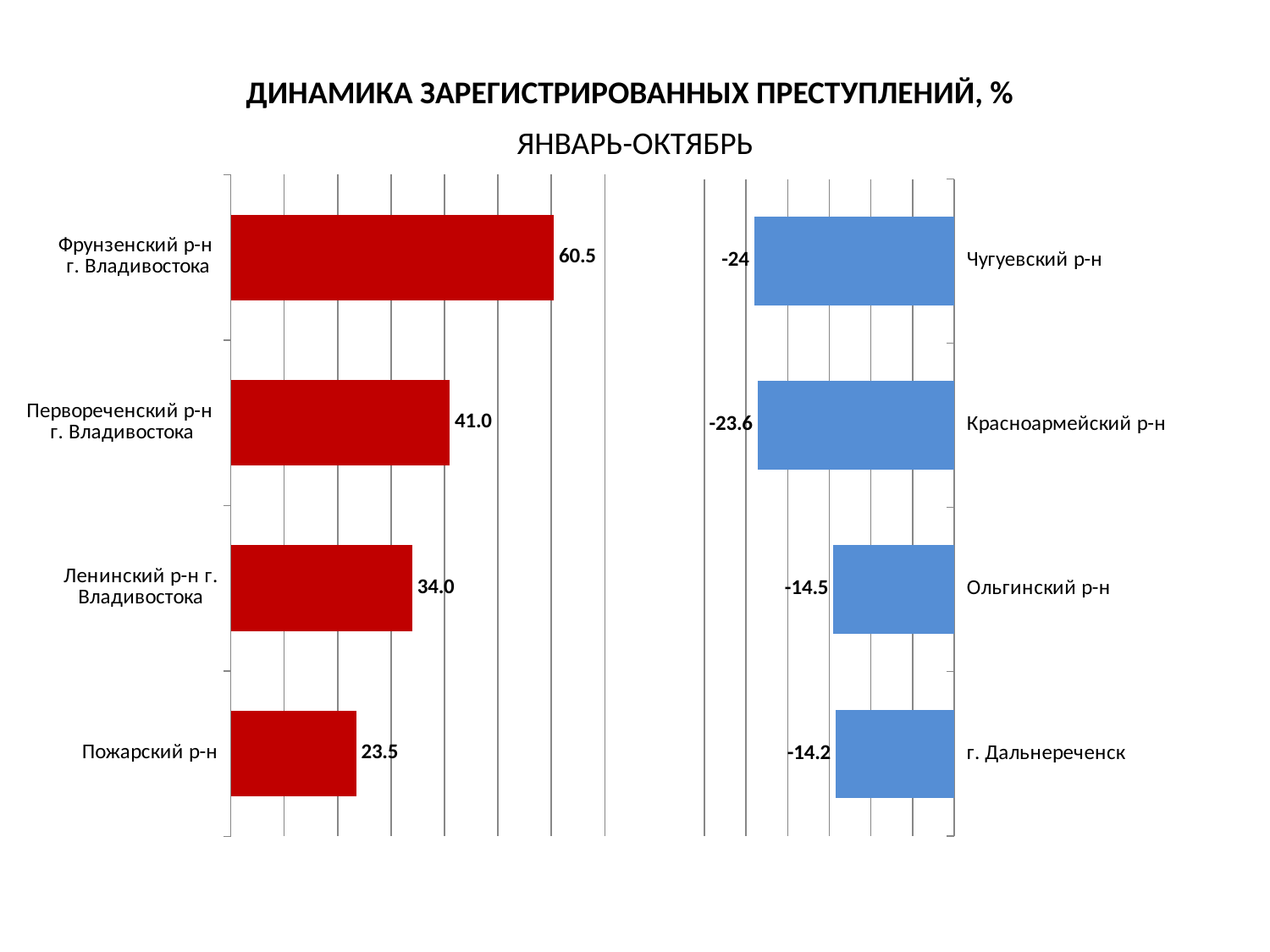
What is the title shown above the two charts? ДИНАМИКА ЗАРЕГИСТРИРОВАННЫХ ПРЕСТУПЛЕНИЙ, % What kind of chart is the right chart with blue bars? Bar chart On the right chart with blue bars, what is the value for г. Дальнереченск? -14.2 On the left chart with red bars, which category has the highest value? Фрунзенский р-н г. Владивостока On the left chart with red bars, what is the difference between the values for Фрунзенский р-н г. Владивостока and Первореченский р-н г. Владивостока? 19.5 On the left chart with red bars, what is the value for Фрунзенский р-н г. Владивостока? 60.5 On the right chart with blue bars, what is the value for Красноармейский р-н? -23.6 How many categories are shown on the left chart with red bars? 4 On the left chart with red bars, which is larger: the value for Ленинский р-н г. Владивостока or Пожарский р-н? Ленинский р-н г. Владивостока On the left chart with red bars, what is the value for Пожарский р-н? 23.5 On the right chart with blue bars, which category has the lowest value? Чугуевский р-н On the right chart with blue bars, what is the difference between the values for Ольгинский р-н and г. Дальнереченск? 0.3